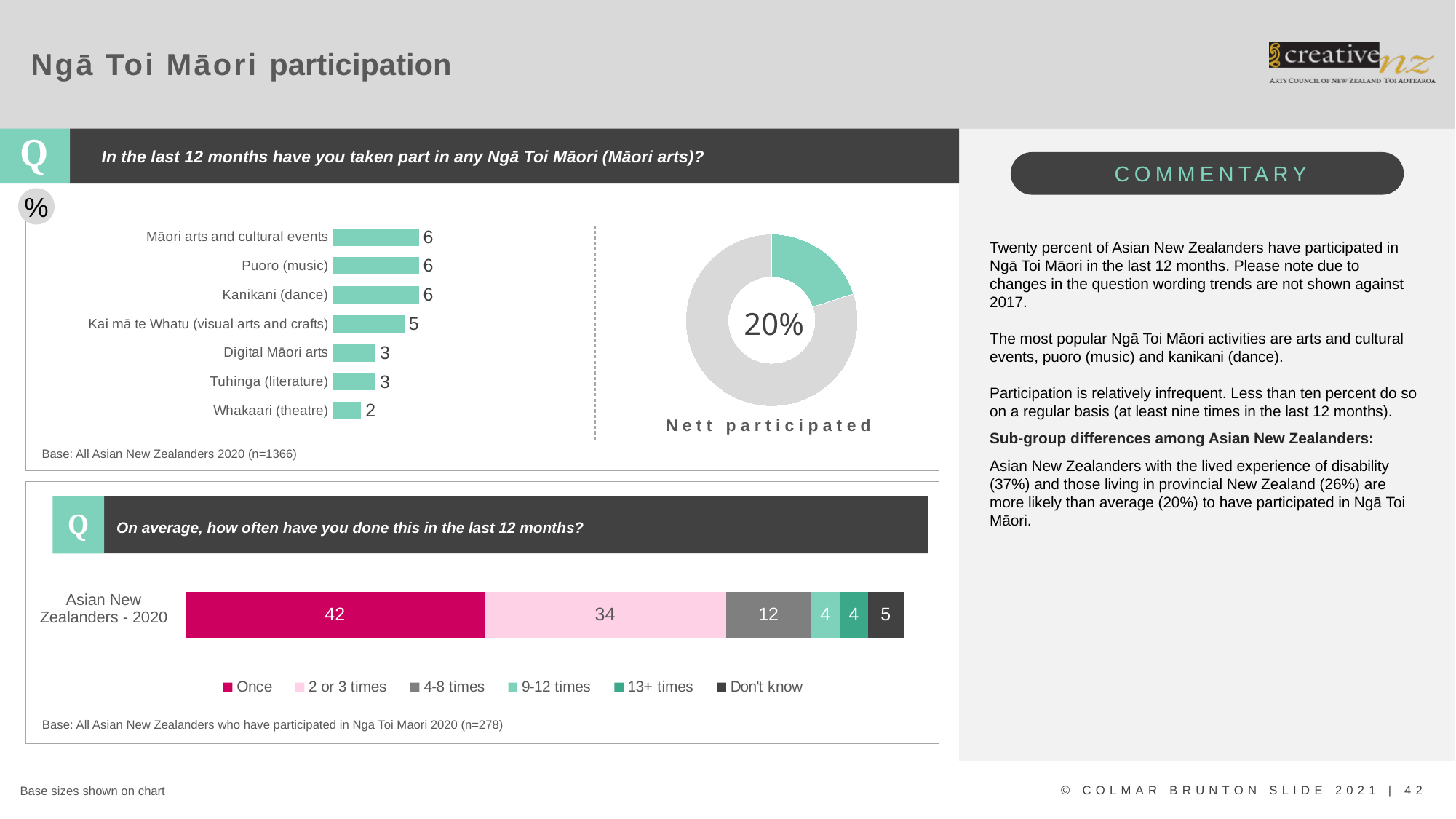
In the bottom stacked bar chart, what is the value for '4-8 times'? 12 In the top-left bar chart, what is the value for Whakaari (theatre)? 2 In the top-left bar chart, what is the value for Kai mā te Whatu (visual arts and crafts)? 5 In the top-left bar chart, which category has the lowest value? Whakaari (theatre) In the bottom stacked bar chart, what is the difference between '2 or 3 times' and 'Don't know'? 29 In the bottom stacked bar chart, what is the value for 'Once'? 42 How many series does the legend of the bottom stacked bar chart list? 6 How many categories are shown in the top-left bar chart? 7 What value is shown in the centre of the 'Nett participated' donut chart? 20% What kind of chart is the top-left chart? Bar chart In the top-left bar chart, which is larger: Digital Māori arts or Kanikani (dance)? Kanikani (dance) In the top-left bar chart, what is the difference between Puoro (music) and Tuhinga (literature)? 3